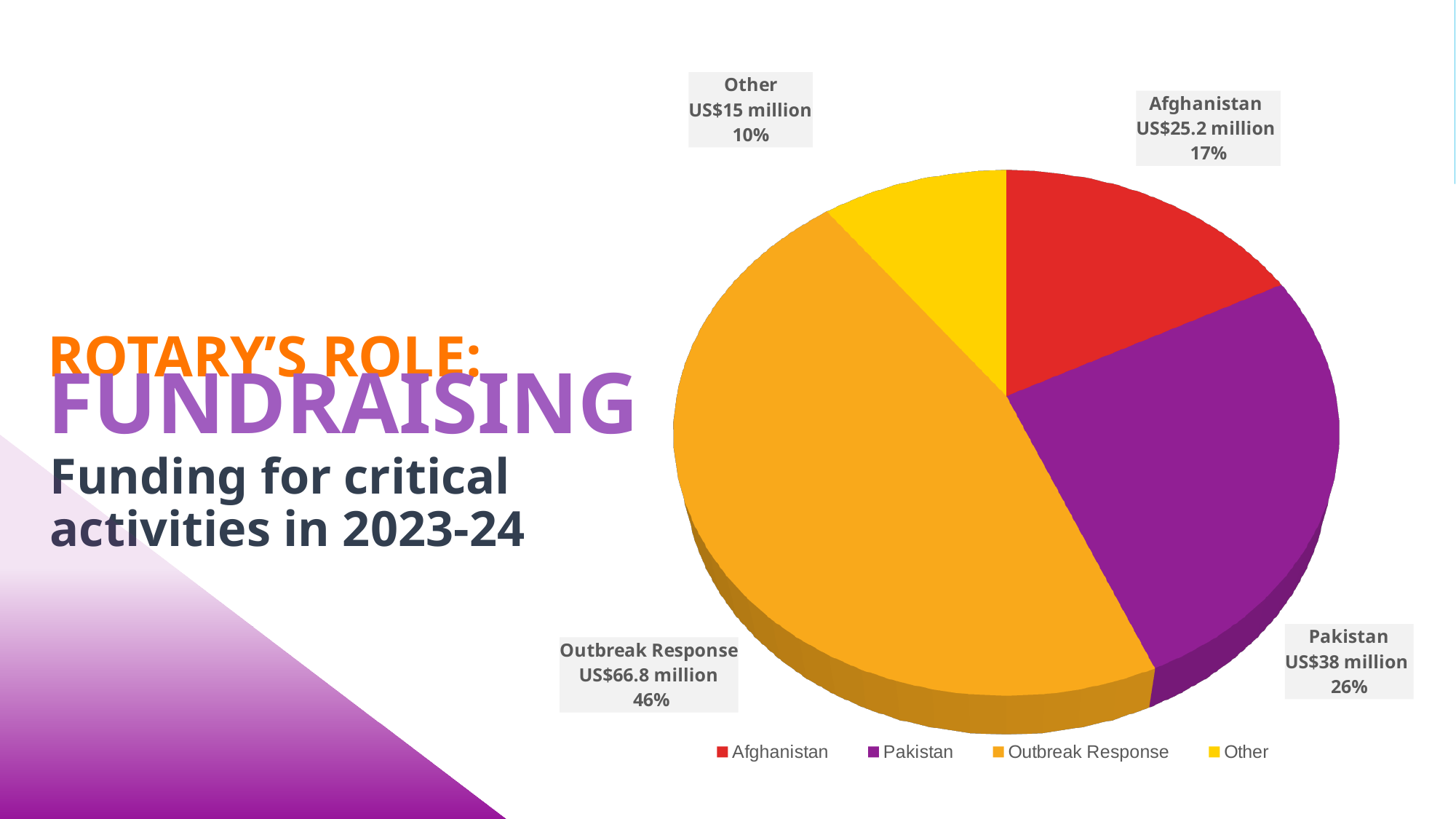
What colour is the Pakistan slice in the pie chart? Purple How many categories are shown in the pie chart? 4 Which category received the largest amount of funding? Outbreak Response What type of chart is shown on the slide? Pie chart Which received more funding, Pakistan or Afghanistan? Pakistan Which category received the smallest amount of funding? Other How much funding is shown for Afghanistan? US$25.2 million How much funding is shown for Outbreak Response? US$66.8 million What percentage share of the pie does Other represent? 10% What percentage share of the pie does Outbreak Response represent? 46% What is the difference in funding between Pakistan and Afghanistan? US$12.8 million How much funding is shown for Pakistan? US$38 million